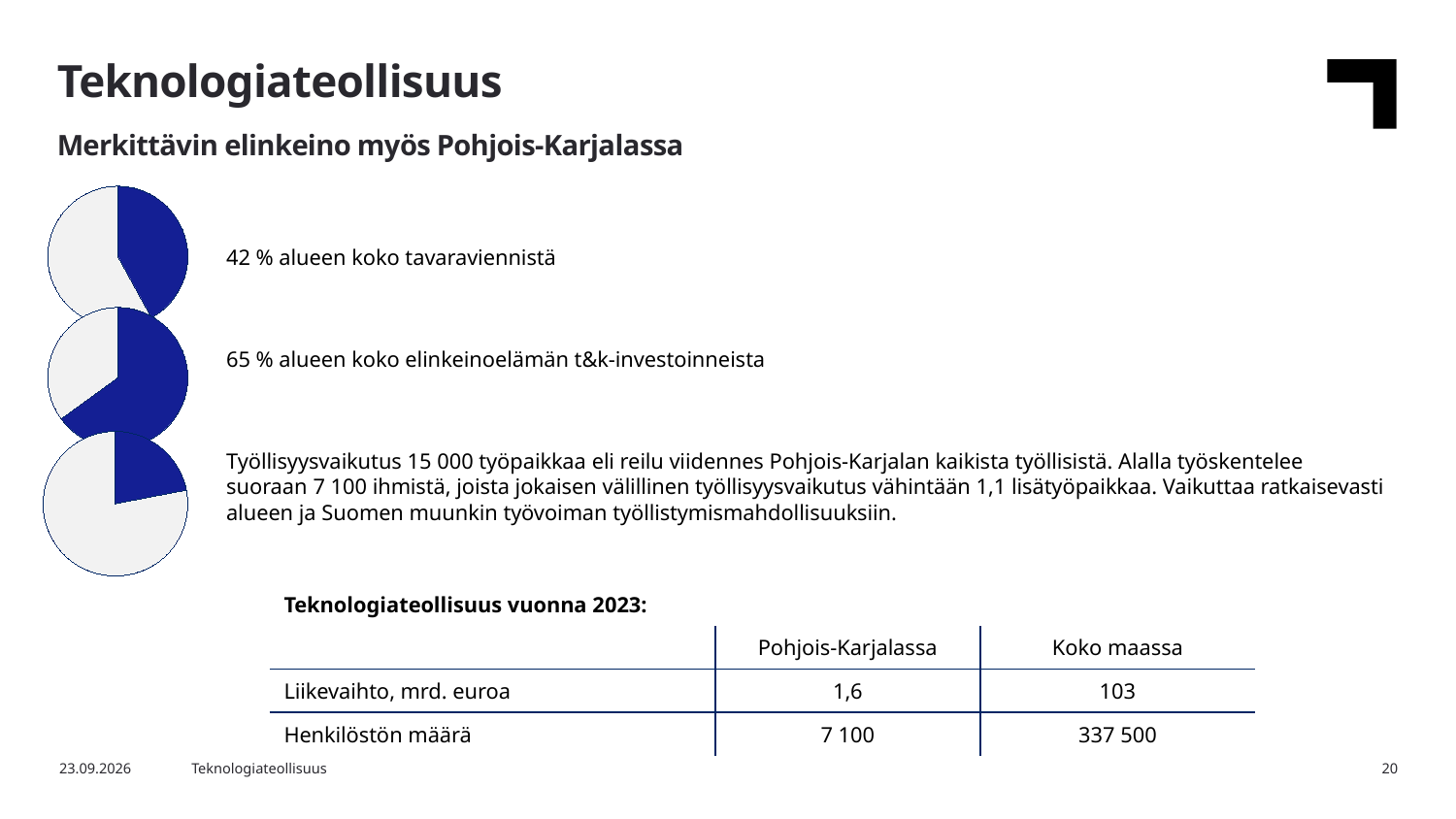
In the middle pie chart, what share of the region's business R&D investments (t&k-investoinnit) does the blue slice represent? 65 % How many slices does each pie chart have? 2 What is the difference in percentage points between the blue slices of the middle pie chart (65 %) and the top pie chart (42 %)? 23 percentage points Which of the three pie charts has the largest blue slice? The middle one (t&k-investoinnit) What colour is used for the highlighted slice in the pie charts? Blue How many pie charts are on the slide? 3 In the top pie chart, what share of the region's total goods exports (tavaravienti) does the blue slice represent? 42 % Which of the three pie charts has the smallest blue slice? The bottom one (työllisyysvaikutus) What kind of charts are shown on the left side of the slide? Pie charts Which pie chart has the larger blue slice, the top one (tavaravienti) or the middle one (t&k-investoinnit)? The middle one (t&k-investoinnit)